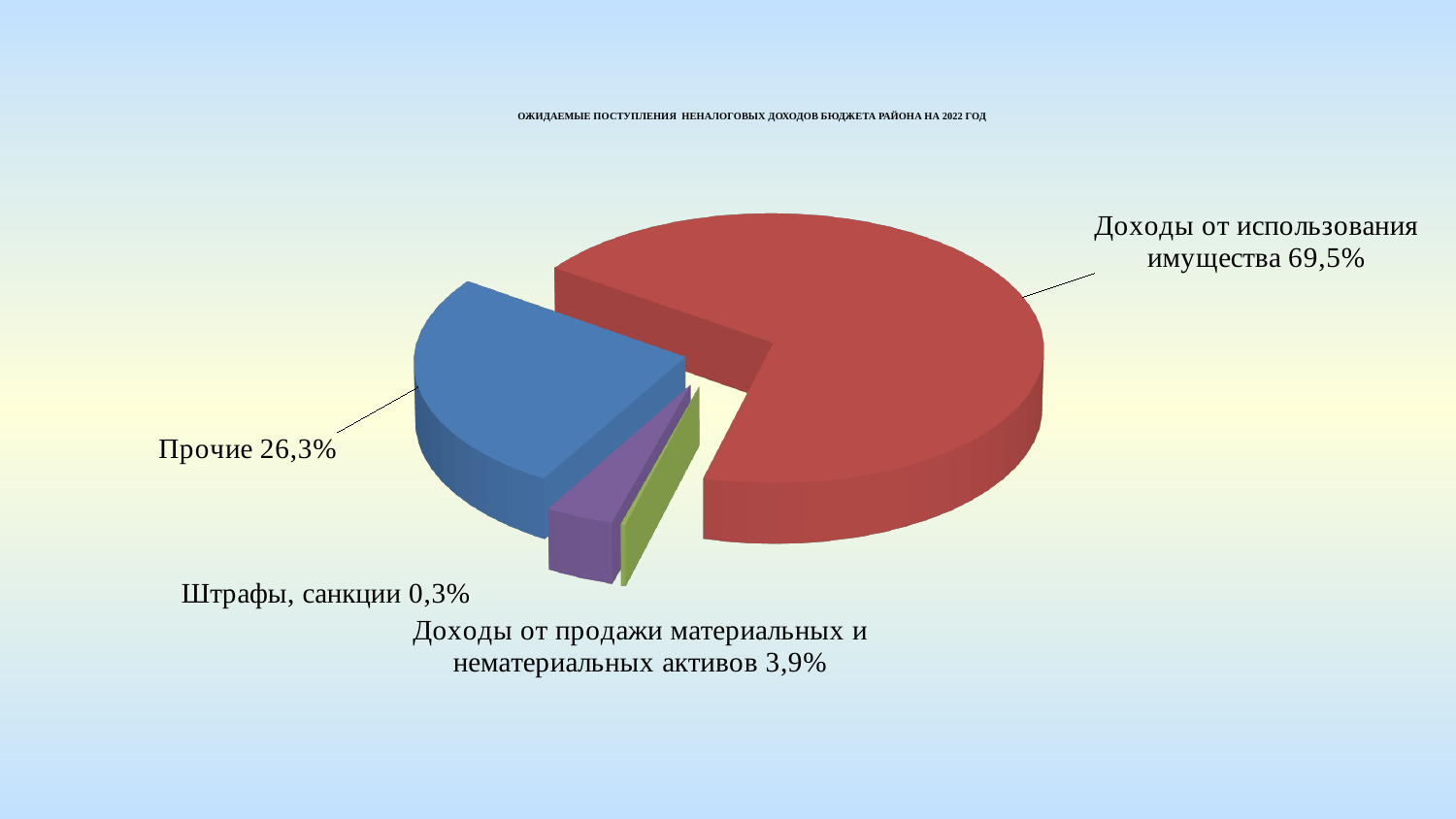
What kind of chart is shown on the slide? Pie chart Which category has the largest share of the pie? Доходы от использования имущества What share of the pie is labelled "Доходы от продажи материальных и нематериальных активов"? 3,9% How many slices does the pie chart have? 4 What share of the pie is labelled "Прочие"? 26,3% What colour is the slice for "Доходы от использования имущества"? Red What is the difference in percentage points between "Доходы от использования имущества" and "Прочие"? 43,2 What share of the pie is labelled "Штрафы, санкции"? 0,3% Which category has the smallest share of the pie? Штрафы, санкции Which is larger: the share for "Прочие" or the share for "Доходы от продажи материальных и нематериальных активов"? Прочие What share of the pie is labelled "Доходы от использования имущества"? 69,5% What colour is the slice for "Прочие"? Blue